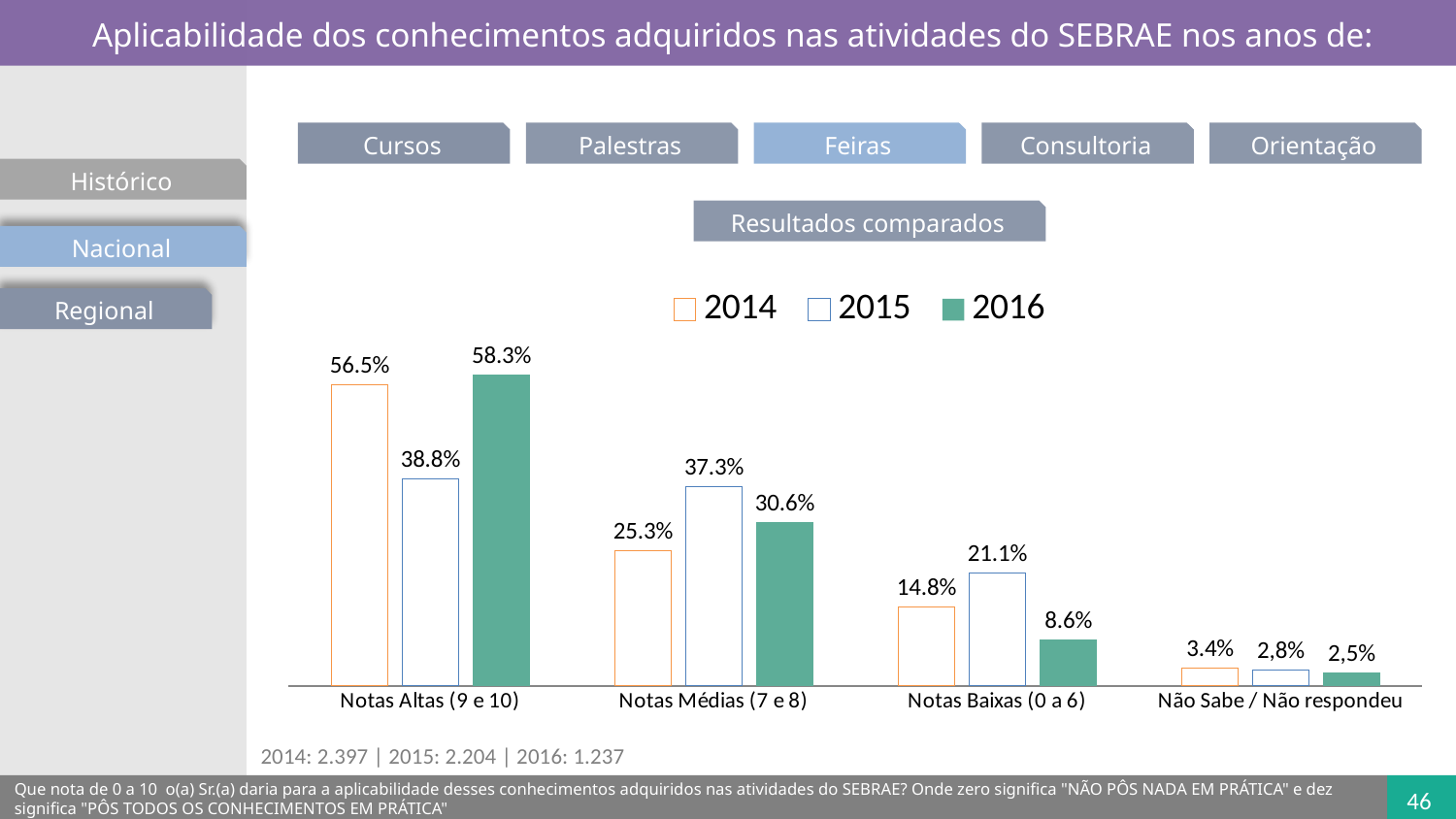
What is the difference between the 2016 and 2015 values for Notas Altas (9 e 10)? 19.5% Which category has the highest 2016 value? Notas Altas (9 e 10) Which series is shown with solid green bars? 2016 How many categories are shown on the x axis? 4 What is the 2016 value for Notas Altas (9 e 10)? 58.3% What is the 2014 value for Notas Baixas (0 a 6)? 14.8% Which category has the lowest 2014 value? Não Sabe / Não respondeu What kind of chart is shown? bar chart How many series does the legend list? 3 What is the 2015 value for Notas Médias (7 e 8)? 37.3% For Notas Baixas (0 a 6), which year has the larger value, 2015 or 2016? 2015 What is the 2015 value for Não Sabe / Não respondeu? 2,8%